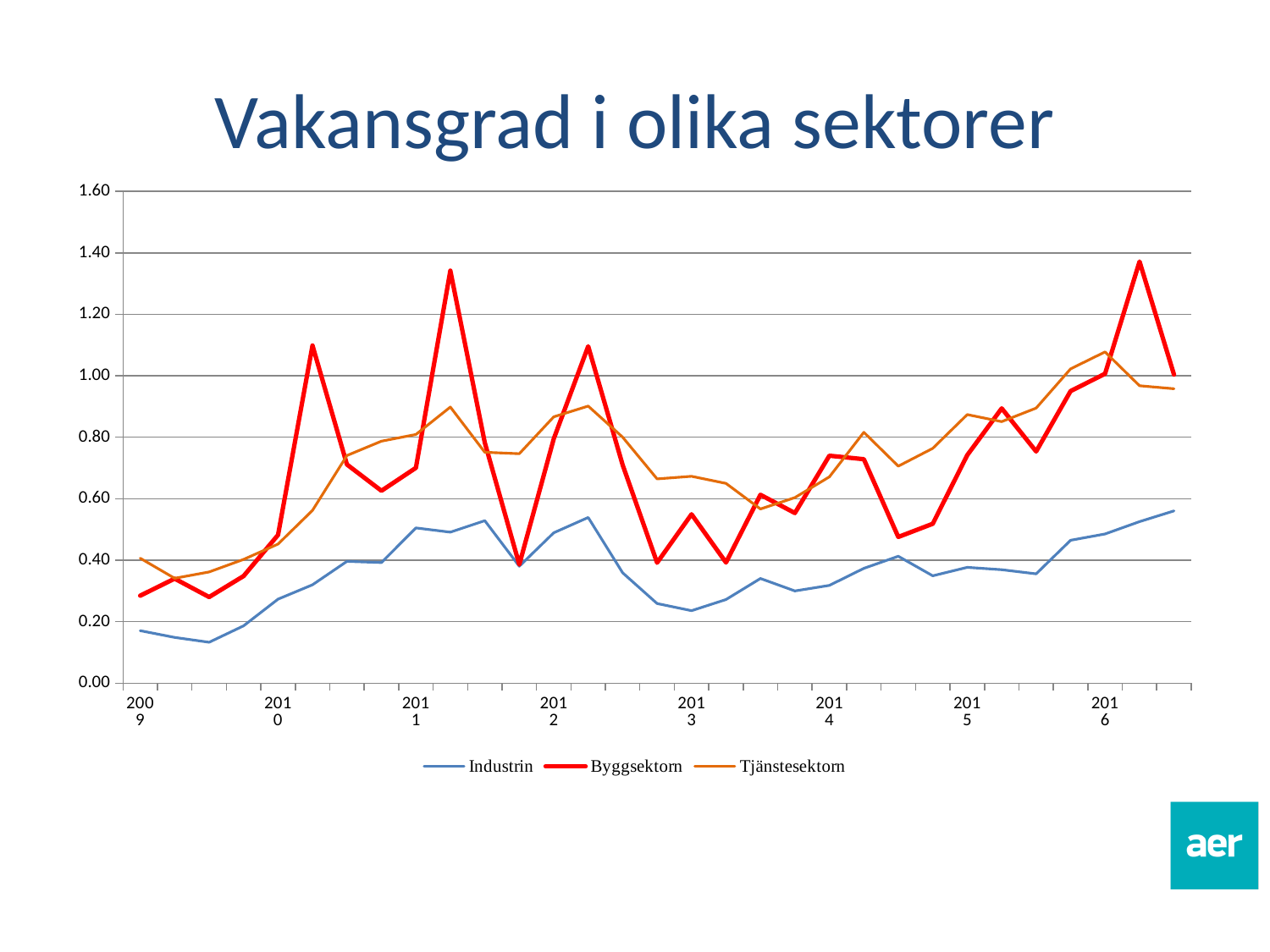
Which series is drawn in red? Byggsektorn Is the peak of Tjänstesektorn in 2016 greater or less than 1.00? greater How many years are labelled on the x axis? 8 What is the title of the chart? Vakansgrad i olika sektorer At the start of 2009, which is higher, Tjänstesektorn or Industrin? Tjänstesektorn Is the value for Industrin at the start of 2013 greater or less than 0.40? less Is the value for Industrin at the start of 2009 greater or less than 0.20? less Does the Industrin series generally rise or fall from 2013 to 2016? rise Which series has the lowest values for most of the period shown? Industrin What kind of chart is shown on the slide? line chart How many series does the legend list? 3